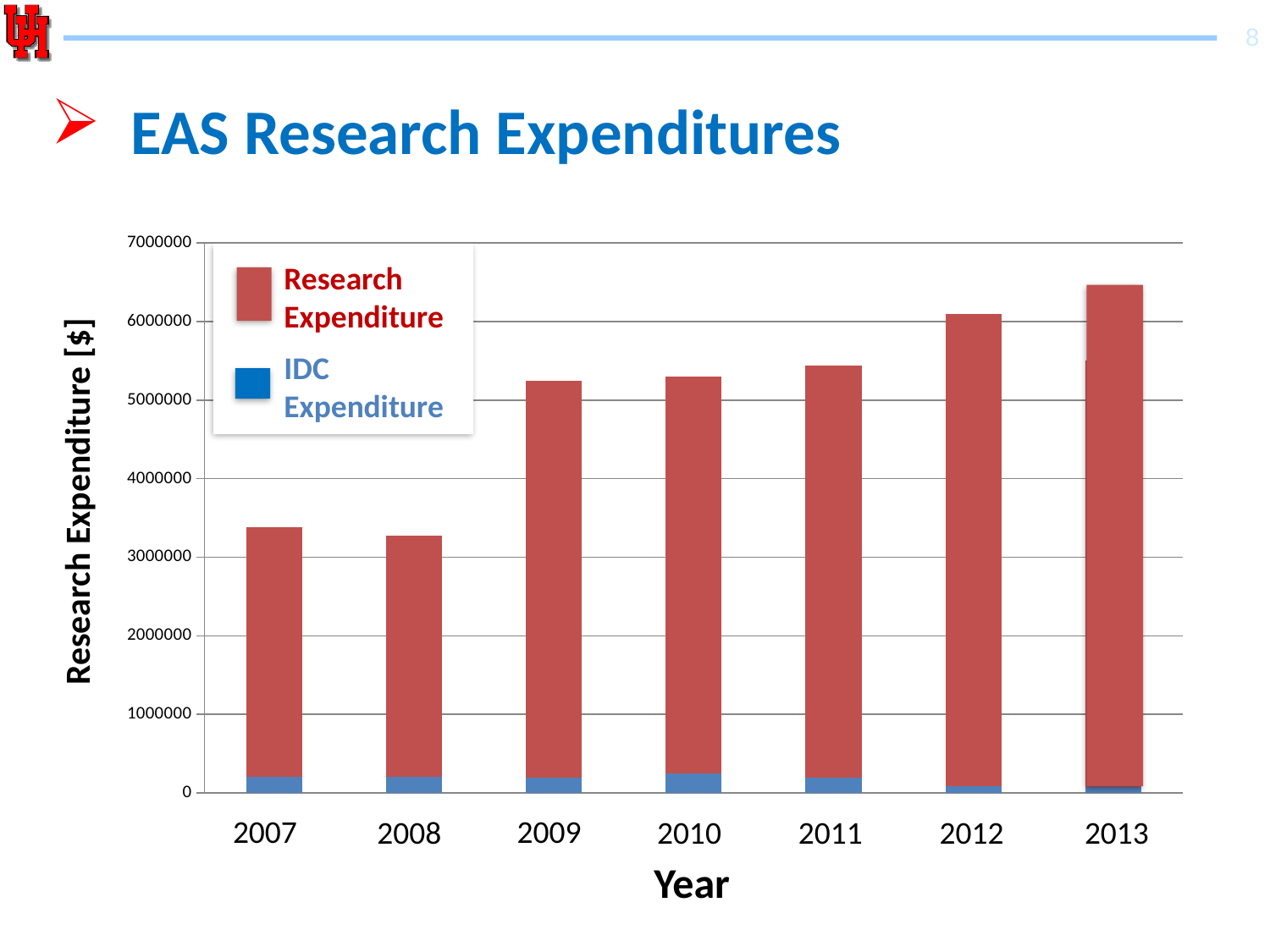
Is the IDC Expenditure for 2010 greater or less than 1000000? less Which year has the highest total bar in the chart? 2013 How many years are shown on the x axis of the chart? 7 What is the label of the y axis of the chart? Research Expenditure [$] Is the total bar for 2013 greater or less than 6000000? greater Do the total bars generally rise or fall from 2007 to 2013? rise How many series does the chart's legend list? 2 Is the total bar for 2009 greater or less than 5000000? greater What kind of chart is shown on the slide? Stacked bar chart Which year has the larger total bar, 2012 or 2009? 2012 Which year has the larger total bar, 2007 or 2013? 2013